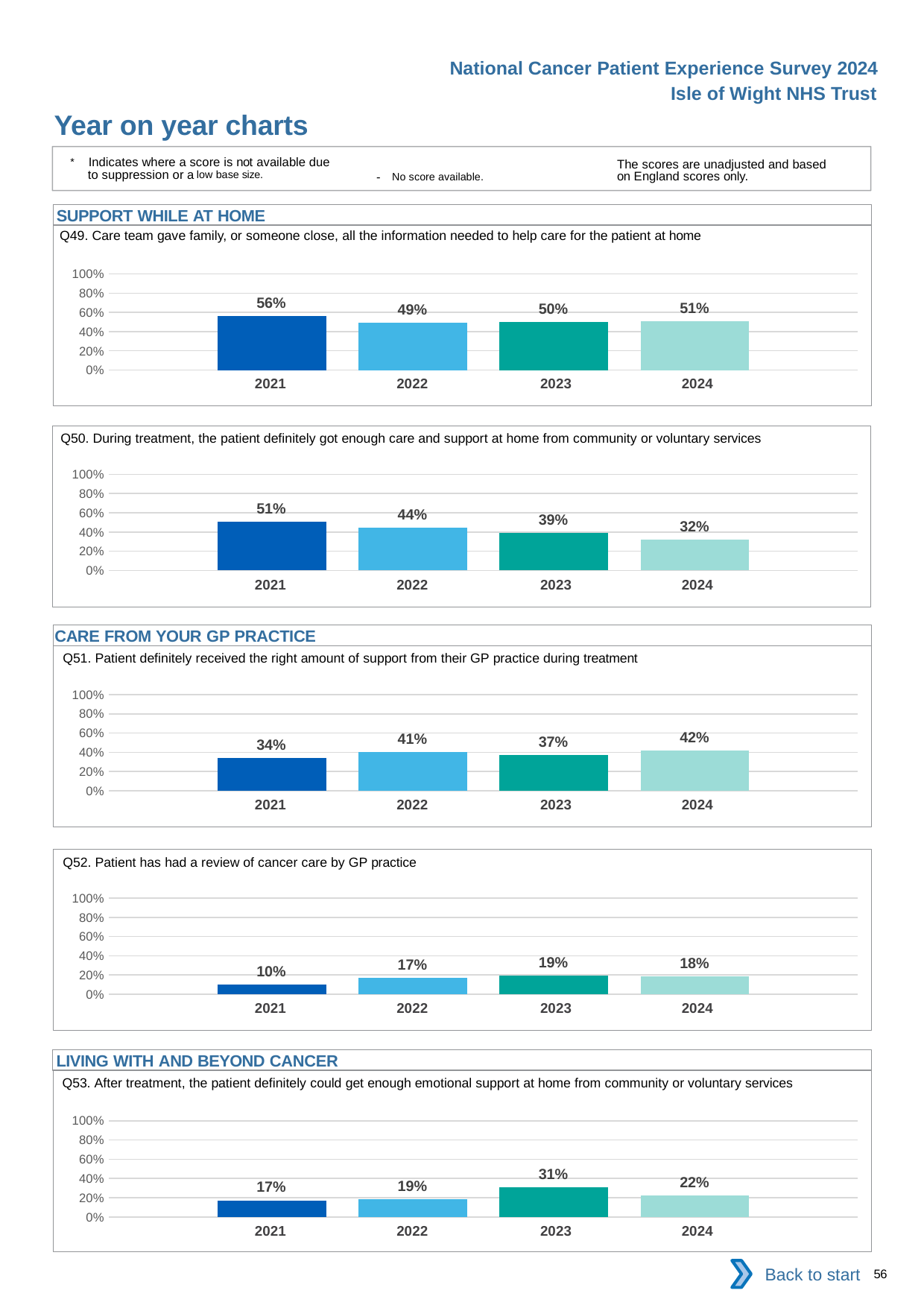
What kind of chart is the Q50 chart? bar chart In the Q51 chart, which year has the highest value? 2024 In the Q53 chart, which is larger, the value for 2023 or the value for 2024? 2023 In the Q50 chart, which year has the lowest value? 2024 In the Q51 chart, what is the difference between the 2024 value and the 2021 value? 8% In the Q52 chart, what is the value for 2023? 19% In the Q49 chart, what is the difference between the 2021 value and the 2022 value? 7% In the Q49 chart, what is the value for 2021? 56% How many years are plotted in the Q49 chart? 4 In the Q50 chart, do the values rise or fall from 2021 to 2024? fall In the Q52 chart, which year has the lowest value? 2021 In the Q53 chart, what is the value for 2022? 19%